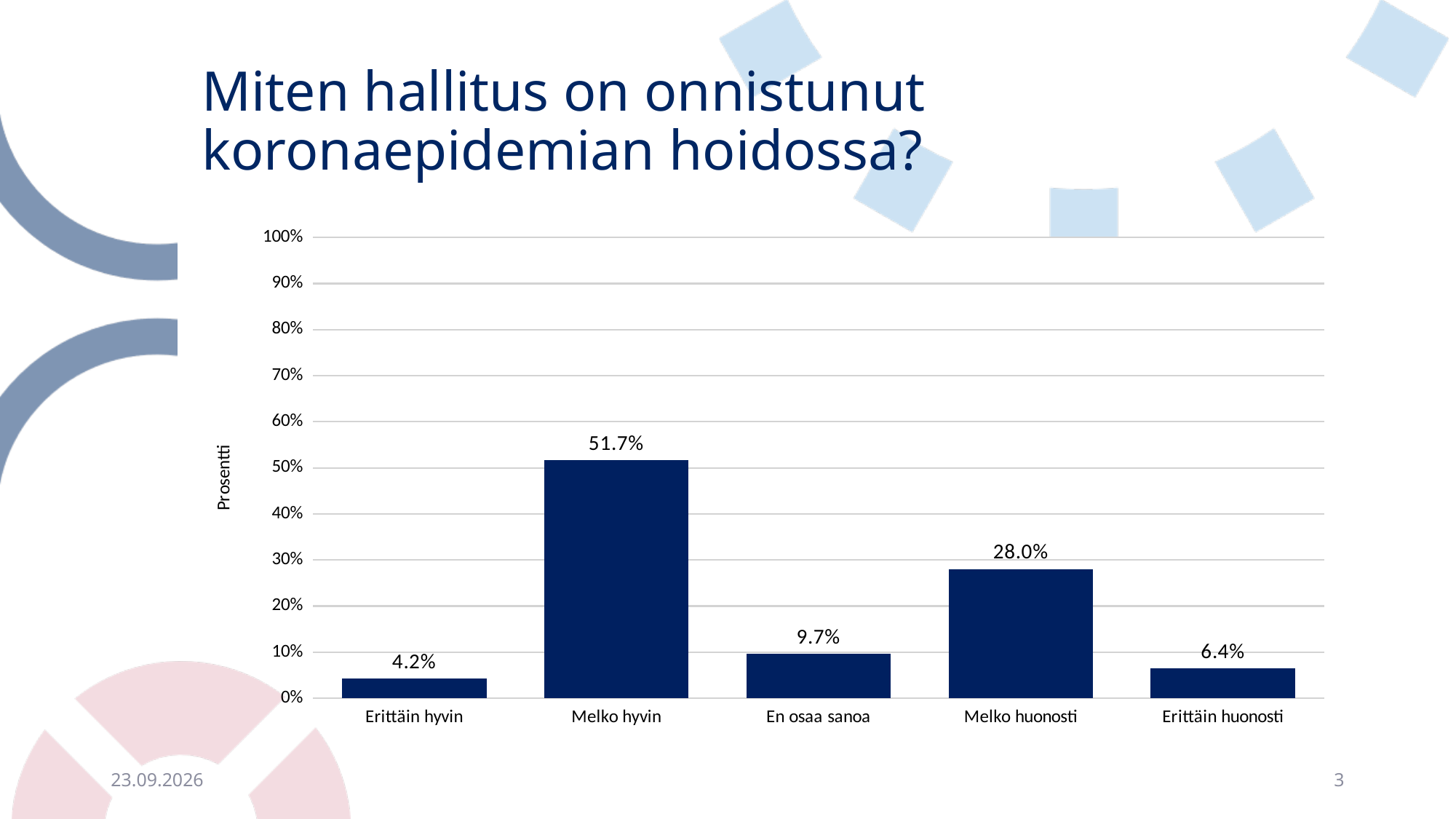
How many categories are shown on the x axis? 5 What is the value for Melko hyvin? 51.7% Is the value for Melko hyvin greater or less than 50%? greater What is the label of the vertical axis? Prosentti Which category has the lowest value? Erittäin hyvin Which is larger, the value for En osaa sanoa or the value for Erittäin huonosti? En osaa sanoa What is the value for Erittäin huonosti? 6.4% What is the difference between the values for Melko hyvin and Melko huonosti? 23.7% What kind of chart is shown on the slide? Bar chart What is the value for Erittäin hyvin? 4.2% What is the value for Melko huonosti? 28.0% Which category has the highest value? Melko hyvin